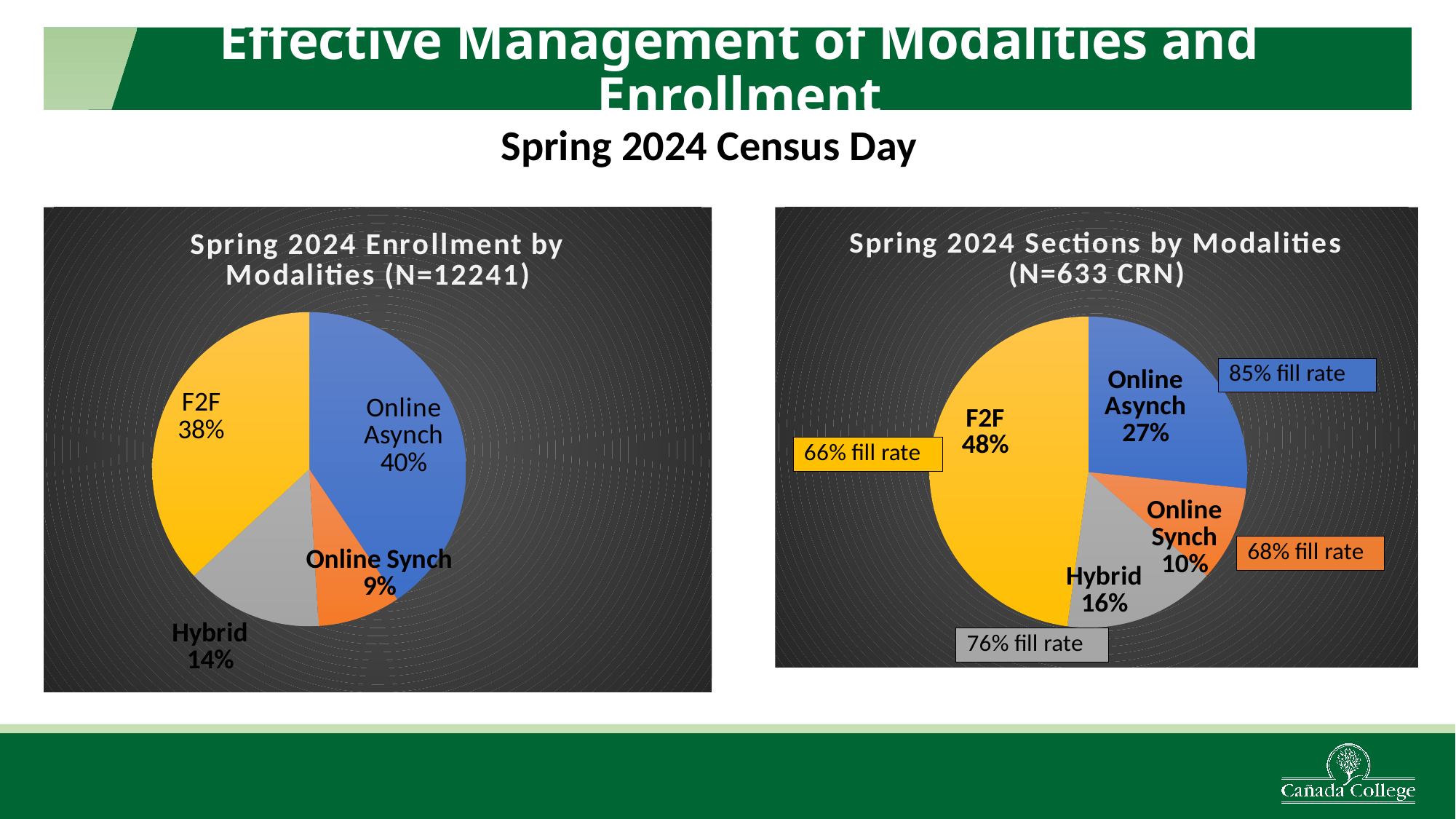
In the 'Spring 2024 Enrollment by Modalities' chart, which modality has the smallest share? Online Synch In the 'Spring 2024 Sections by Modalities' chart, which modality has the largest share? F2F In the 'Spring 2024 Sections by Modalities' chart, what is the fill rate shown for Hybrid? 76% fill rate In the 'Spring 2024 Sections by Modalities' chart, what share of sections is Online Synch? 10% What kind of chart is the 'Spring 2024 Enrollment by Modalities' chart? Pie chart In the 'Spring 2024 Enrollment by Modalities' chart, what is the difference in percentage points between F2F and Hybrid? 24 In the 'Spring 2024 Enrollment by Modalities' chart, what share of enrollment is Online Asynch? 40% In the 'Spring 2024 Sections by Modalities' chart, what share of sections is F2F? 48% In the 'Spring 2024 Sections by Modalities' chart, what is the fill rate shown for Online Asynch? 85% fill rate In the 'Spring 2024 Enrollment by Modalities' chart, which modality has the largest share? Online Asynch How many slices does the 'Spring 2024 Sections by Modalities' pie chart have? 4